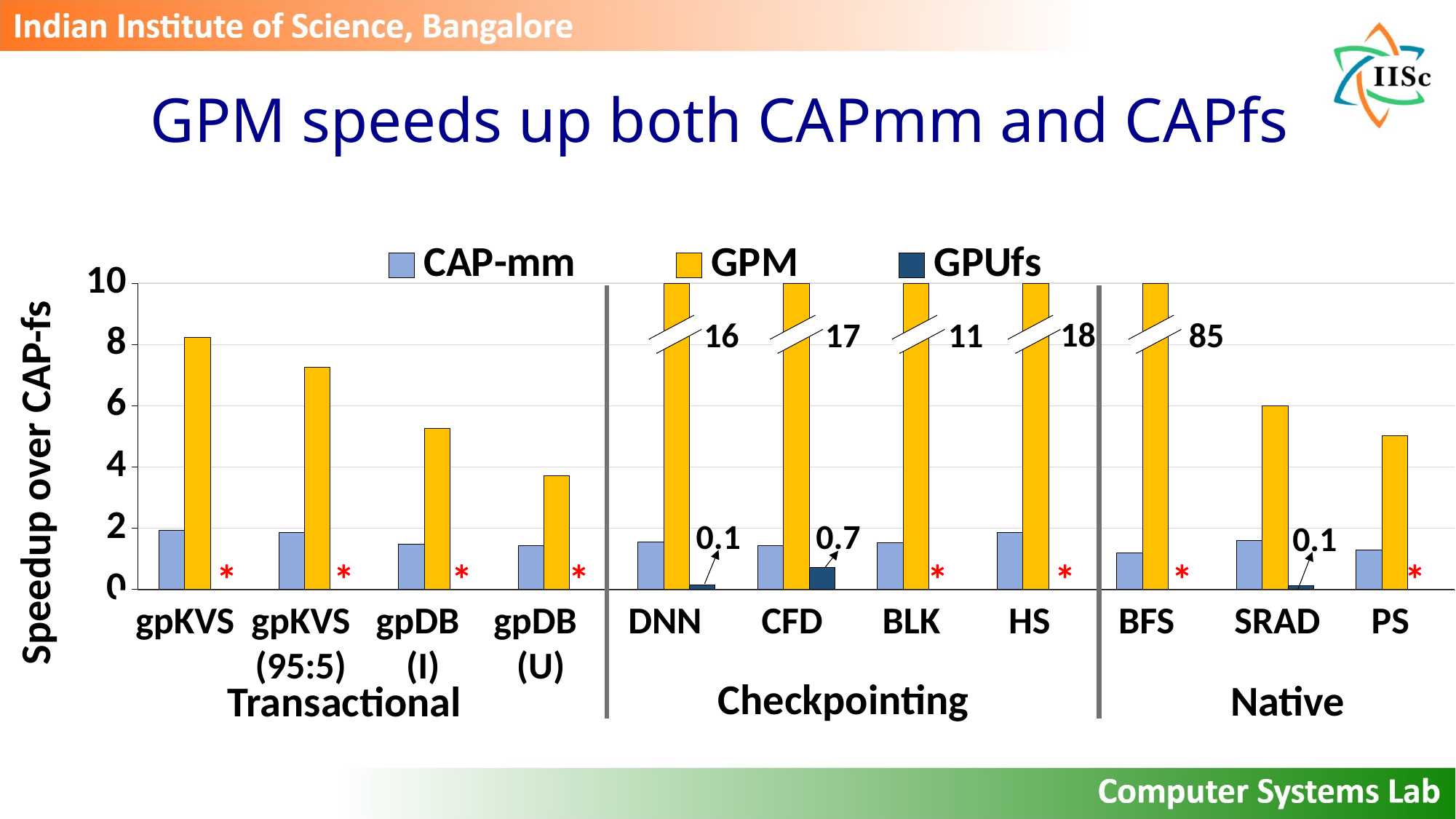
What is the difference between the GPM speedup for HS and for BLK? 7 What type of chart is shown on the slide? Bar chart Is the GPM value for SRAD greater or less than 4? greater How many series does the legend list? 3 What is the GPM speedup for CFD? 17 Which category has the highest GPM speedup? BFS What is the GPM speedup for BFS? 85 What is the title of the y axis? Speedup over CAP-fs How many categories (benchmarks) are shown on the x axis? 11 What is the GPUfs value for CFD? 0.7 What is the GPUfs value for DNN? 0.1 Which has a larger GPM speedup, gpKVS or gpDB (U)? gpKVS